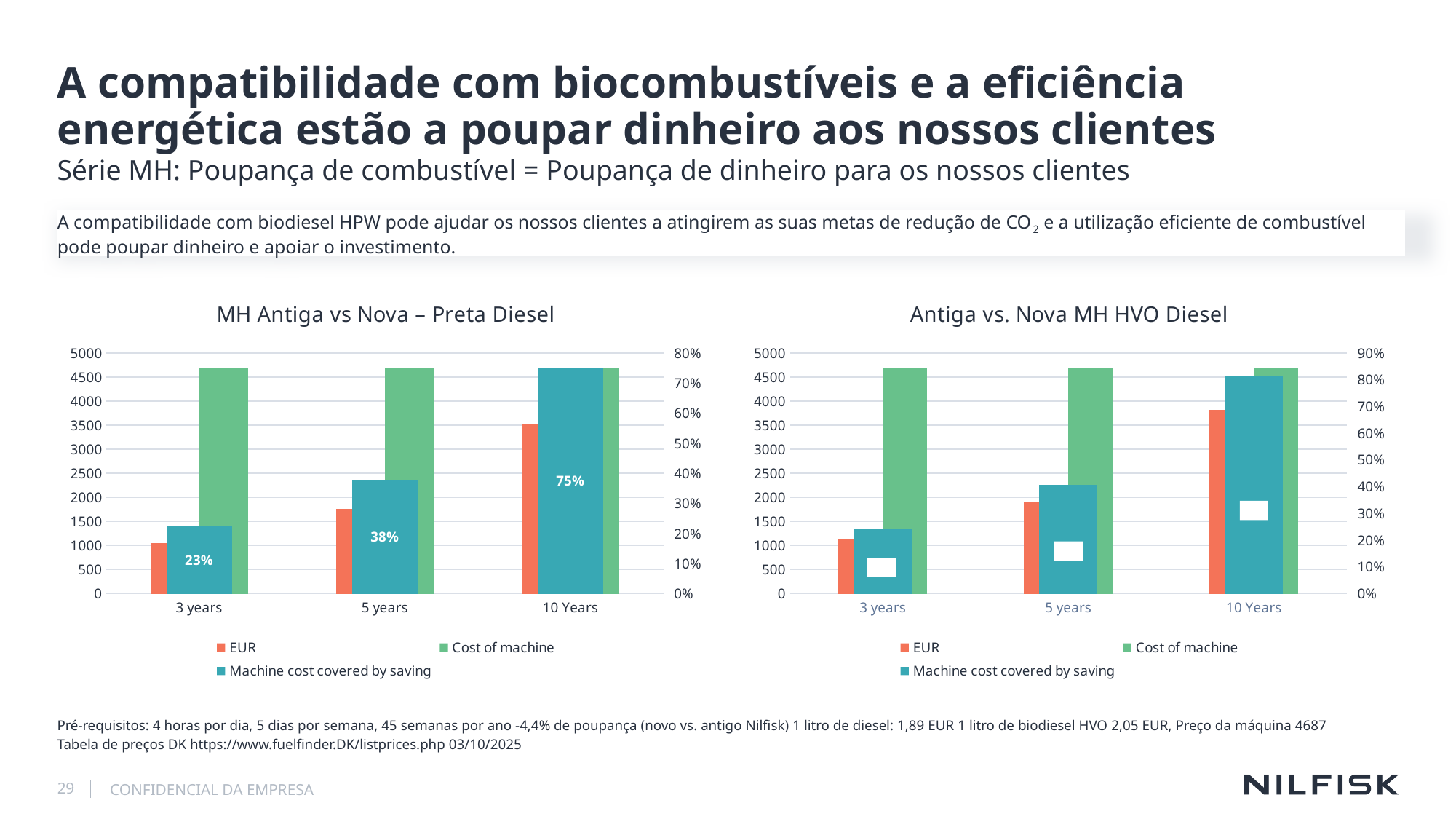
In the chart 'MH Antiga vs Nova – Preta Diesel', what is the value of 'Machine cost covered by saving' at 5 years? 38% In the chart 'MH Antiga vs Nova – Preta Diesel', is the EUR value at 3 years greater or less than 1500? less How many categories are shown on the x axis of the chart 'Antiga vs. Nova MH HVO Diesel'? 3 How many series does the legend of the chart 'MH Antiga vs Nova – Preta Diesel' list? 3 In the chart 'MH Antiga vs Nova – Preta Diesel', what is the value of 'Machine cost covered by saving' at 10 Years? 75% In the chart 'MH Antiga vs Nova – Preta Diesel', what is the difference between 'Machine cost covered by saving' at 10 Years and at 3 years? 52% In the chart 'Antiga vs. Nova MH HVO Diesel', is the EUR value at 3 years greater or less than 1000? greater In the chart 'MH Antiga vs Nova – Preta Diesel', what is the value of 'Machine cost covered by saving' at 3 years? 23% In the chart 'MH Antiga vs Nova – Preta Diesel', which category has the highest 'Machine cost covered by saving'? 10 Years In the chart 'Antiga vs. Nova MH HVO Diesel', do the EUR values rise or fall from 3 years to 10 Years? rise In the chart 'MH Antiga vs Nova – Preta Diesel', which is larger, the EUR value at 10 Years or at 5 years? 10 Years In the chart 'Antiga vs. Nova MH HVO Diesel', is the EUR value at 10 Years greater or less than 3500? greater